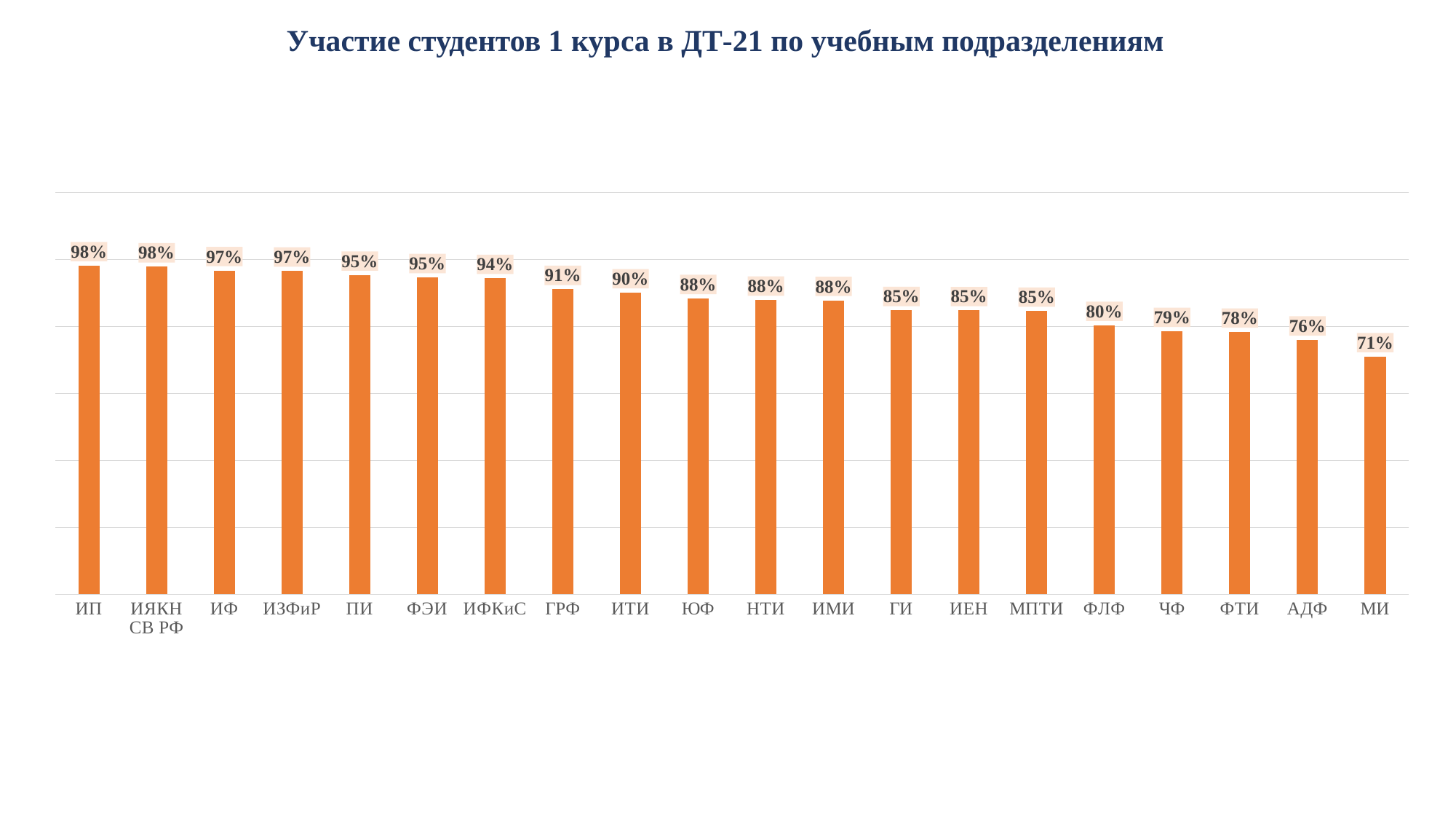
Which is larger, the value for ФТИ or the value for ЮФ? ЮФ What is the value for АДФ? 76% Which category has the lowest value? МИ What is the difference between the values for ИП and МИ? 27% Do the values rise or fall from left to right along the x axis? Fall What is the difference between the values for ИТИ and ЧФ? 11% What kind of chart is shown on the slide? Bar chart What is the value for ФЛФ? 80% What is the value for ГРФ? 91% Which is larger, the value for ПИ or the value for ГИ? ПИ What is the value for ИФКиС? 94% How many categories are shown on the chart? 20